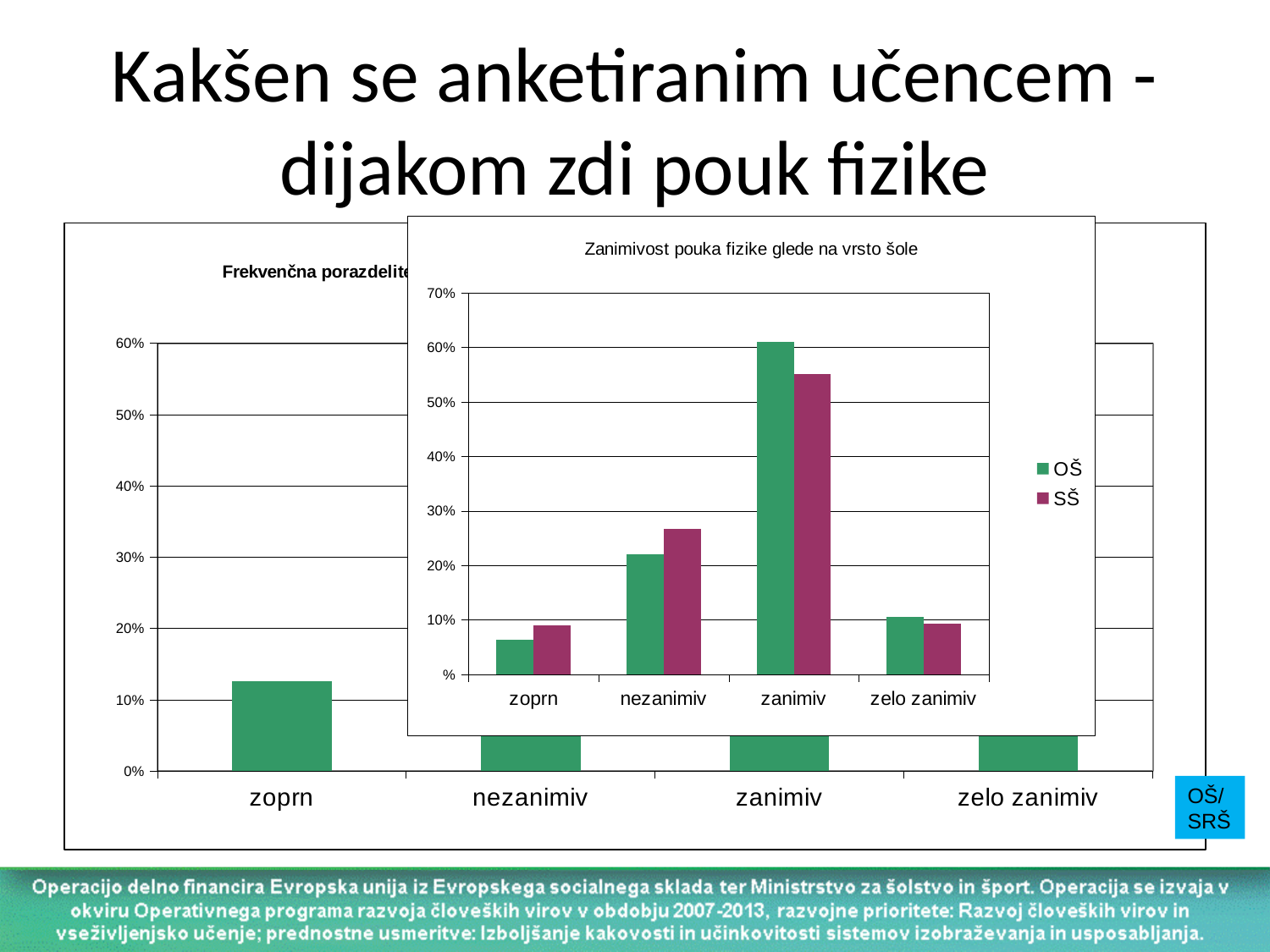
In the chart titled "Zanimivost pouka fizike glede na vrsto šole", which category has the lowest value for OŠ? zoprn In the chart titled "Zanimivost pouka fizike glede na vrsto šole", is the OŠ value for "zanimiv" greater or less than 50%? greater In the chart titled "Zanimivost pouka fizike glede na vrsto šole", how many categories are on the x axis? 4 In the chart titled "Zanimivost pouka fizike glede na vrsto šole", is the SŠ value for "zoprn" greater or less than 10%? less In the chart titled "Zanimivost pouka fizike glede na vrsto šole", how many series does the legend list? 2 In the chart titled "Zanimivost pouka fizike glede na vrsto šole", what kind of chart is shown? bar chart In the chart titled "Zanimivost pouka fizike glede na vrsto šole", which category has the highest value for SŠ? zanimiv In the chart titled "Zanimivost pouka fizike glede na vrsto šole", which category has the highest value for OŠ? zanimiv In the chart titled "Zanimivost pouka fizike glede na vrsto šole", what are the legend entries? OŠ, SŠ In the chart titled "Zanimivost pouka fizike glede na vrsto šole", for the category "zanimiv", which series has the larger value, OŠ or SŠ? OŠ In the chart titled "Zanimivost pouka fizike glede na vrsto šole", is the SŠ value for "nezanimiv" greater or less than 20%? greater In the chart titled "Zanimivost pouka fizike glede na vrsto šole", for the category "nezanimiv", which series has the larger value, OŠ or SŠ? SŠ